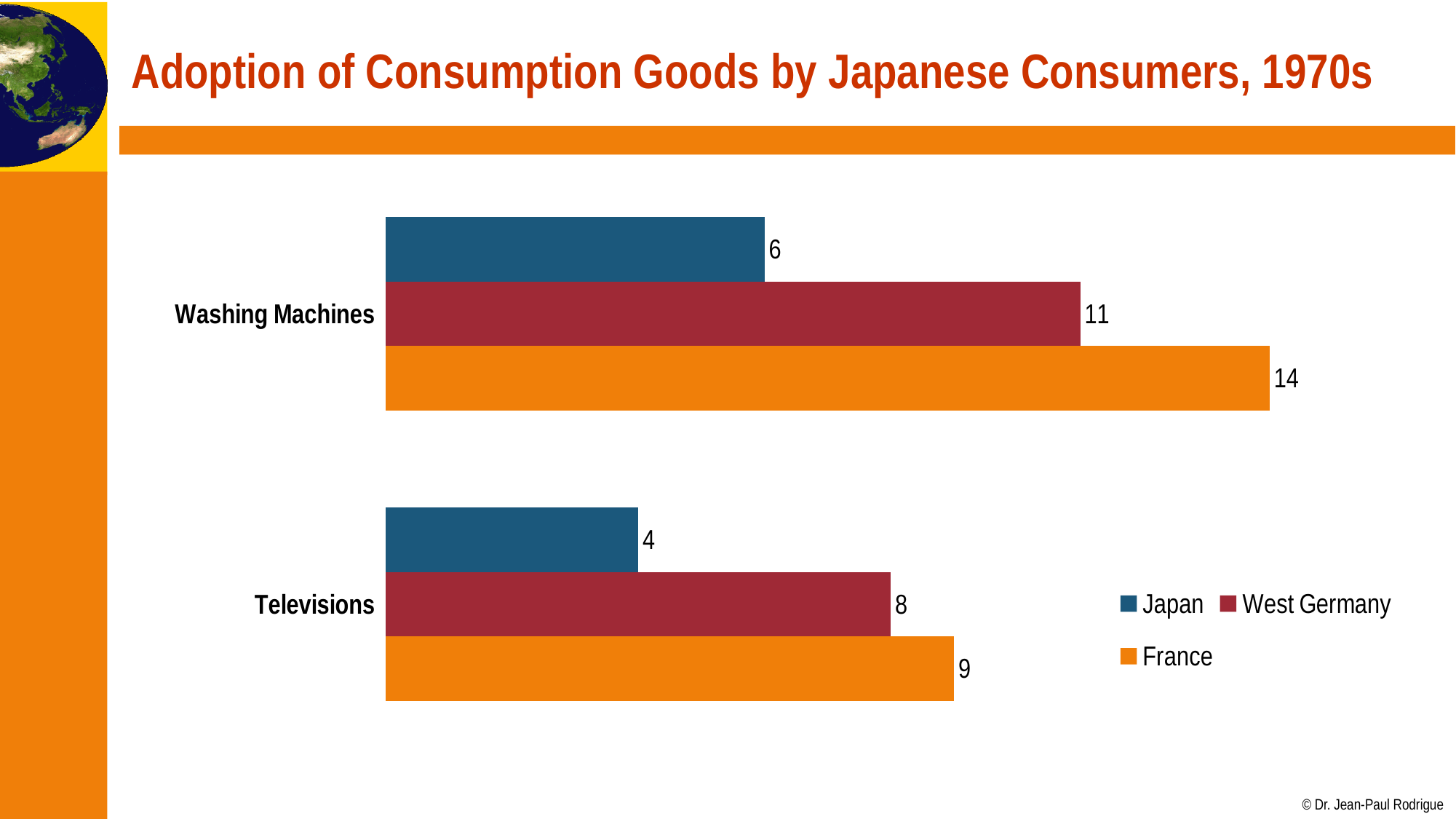
Which country has the lowest value for Televisions? Japan What is the value for Japan for Televisions? 4 What is the value for West Germany for Televisions? 8 What is the difference between West Germany and Japan for Televisions? 4 How many categories are shown on the chart? 2 What kind of chart is shown on the slide? Bar chart Which is larger: West Germany for Washing Machines or France for Televisions? West Germany for Washing Machines What is the value for France for Washing Machines? 14 How many series does the legend list? 3 What is the value for Japan for Washing Machines? 6 Which country has the highest value for Washing Machines? France What is the difference between France and Japan for Washing Machines? 8